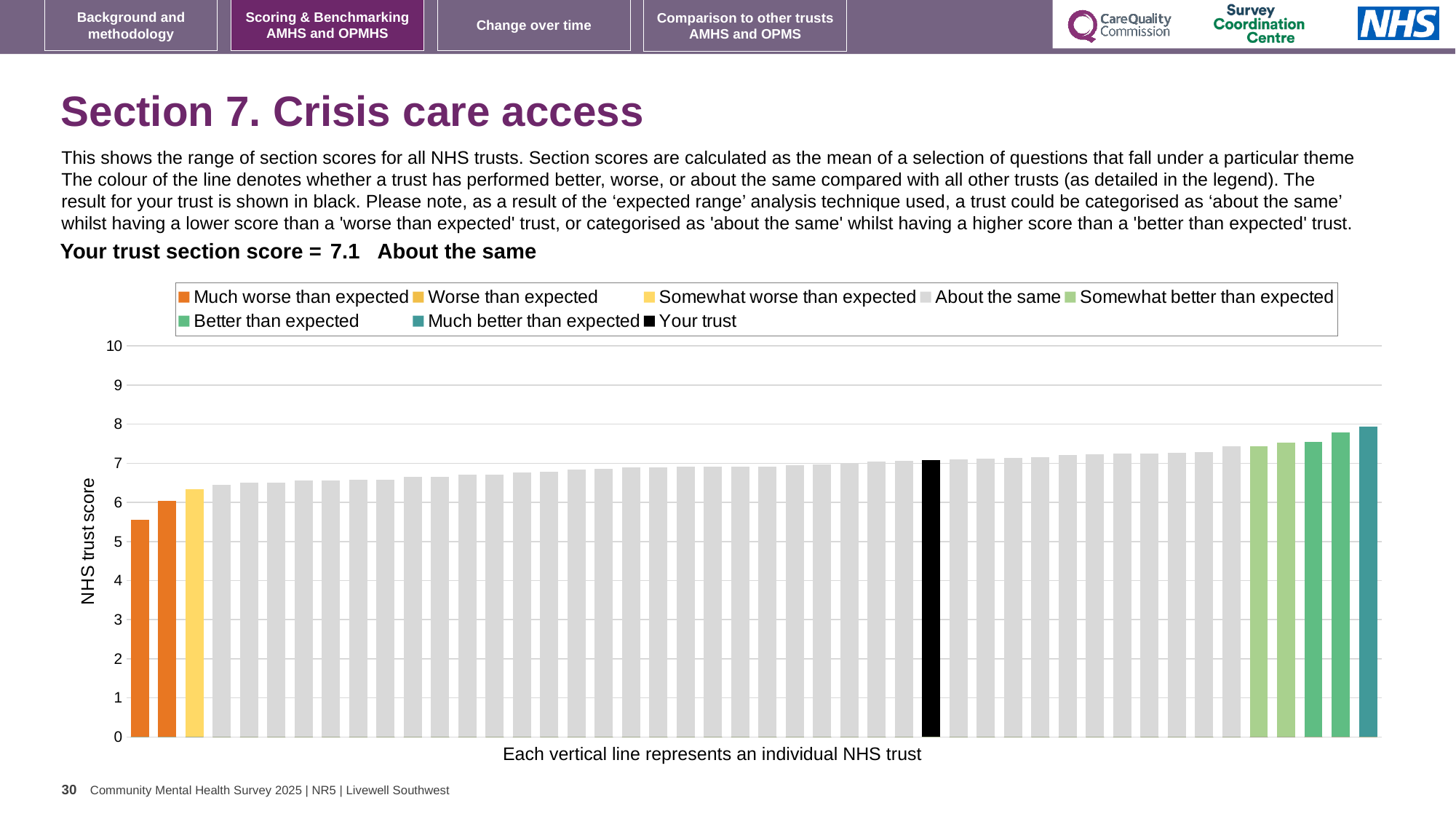
Do the bar values rise or fall from left to right across the chart? rise Which category is your trust placed in for Section 7 Crisis care access? About the same Which legend category does the highest bar in the chart belong to? Much better than expected What is the section score for your trust shown on the slide? 7.1 Which legend category does the lowest bar in the chart belong to? Much worse than expected Is the value of the highest bar in the chart greater or less than 7? greater What is the label on the vertical axis of the chart? NHS trust score Is the value of the lowest bar in the chart greater or less than 6? less How many entries does the chart legend list? 8 How many bars in the chart are coloured as 'Much worse than expected'? 2 What does the label below the horizontal axis say? Each vertical line represents an individual NHS trust What kind of chart is shown on the slide? bar chart